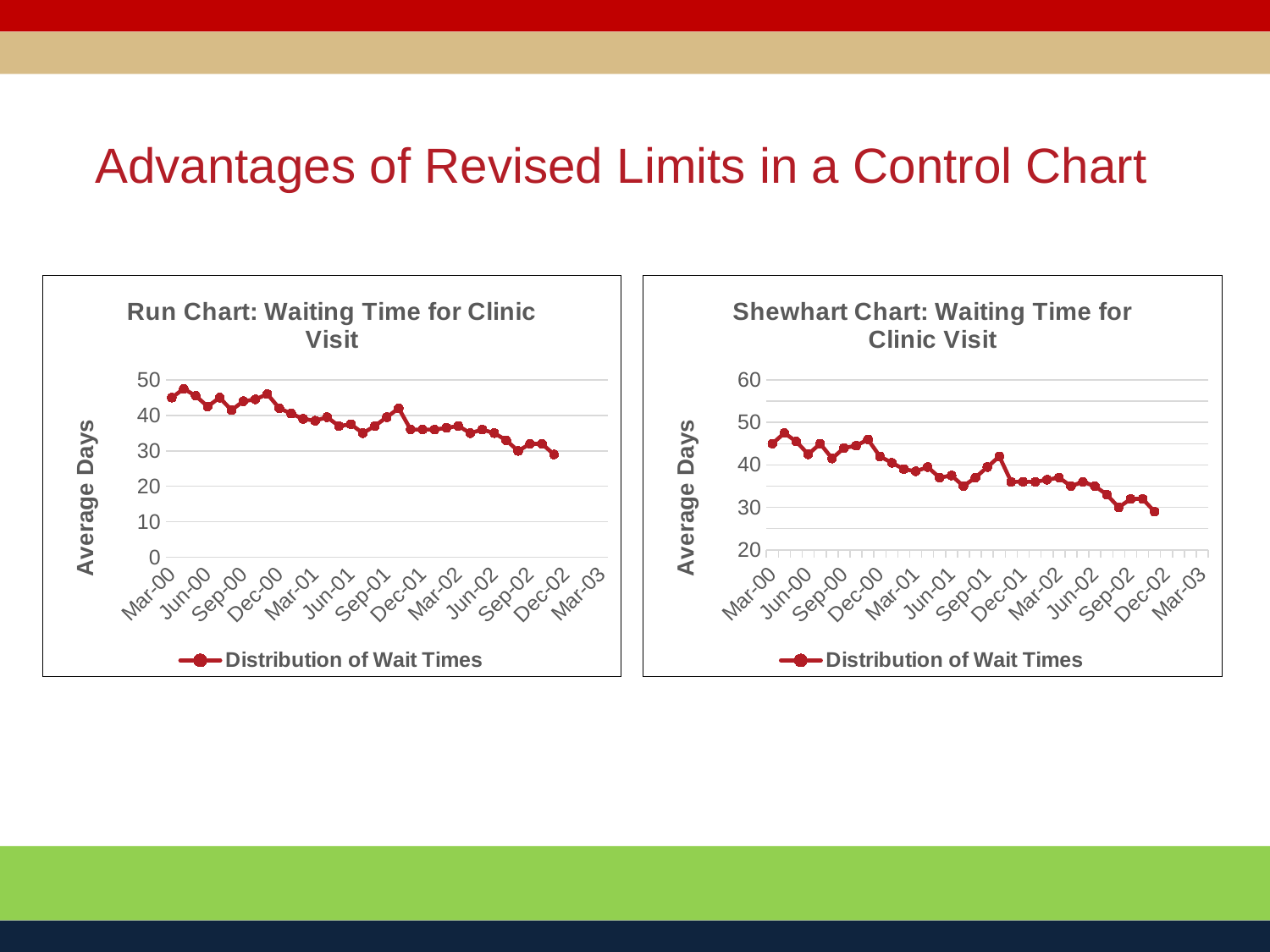
What is the y-axis label of the Run Chart: Waiting Time for Clinic Visit? Average Days What kind of chart is the Shewhart Chart: Waiting Time for Clinic Visit? Line chart In the Shewhart Chart: Waiting Time for Clinic Visit, do the values generally rise or fall from Mar-00 to Dec-02? Fall In the Run Chart: Waiting Time for Clinic Visit, do the values generally rise or fall along the x axis? Fall What is the legend entry in the Shewhart Chart: Waiting Time for Clinic Visit? Distribution of Wait Times In the Run Chart: Waiting Time for Clinic Visit, is the value for Mar-00 greater or less than 40? greater What kind of chart is the Run Chart: Waiting Time for Clinic Visit? Line chart In the Run Chart: Waiting Time for Clinic Visit, which is larger, the value for Jun-00 or the value for Sep-02? Jun-00 In the Run Chart: Waiting Time for Clinic Visit, is the value for Jun-01 greater or less than 40? less How many series does the legend of the Run Chart: Waiting Time for Clinic Visit list? 1